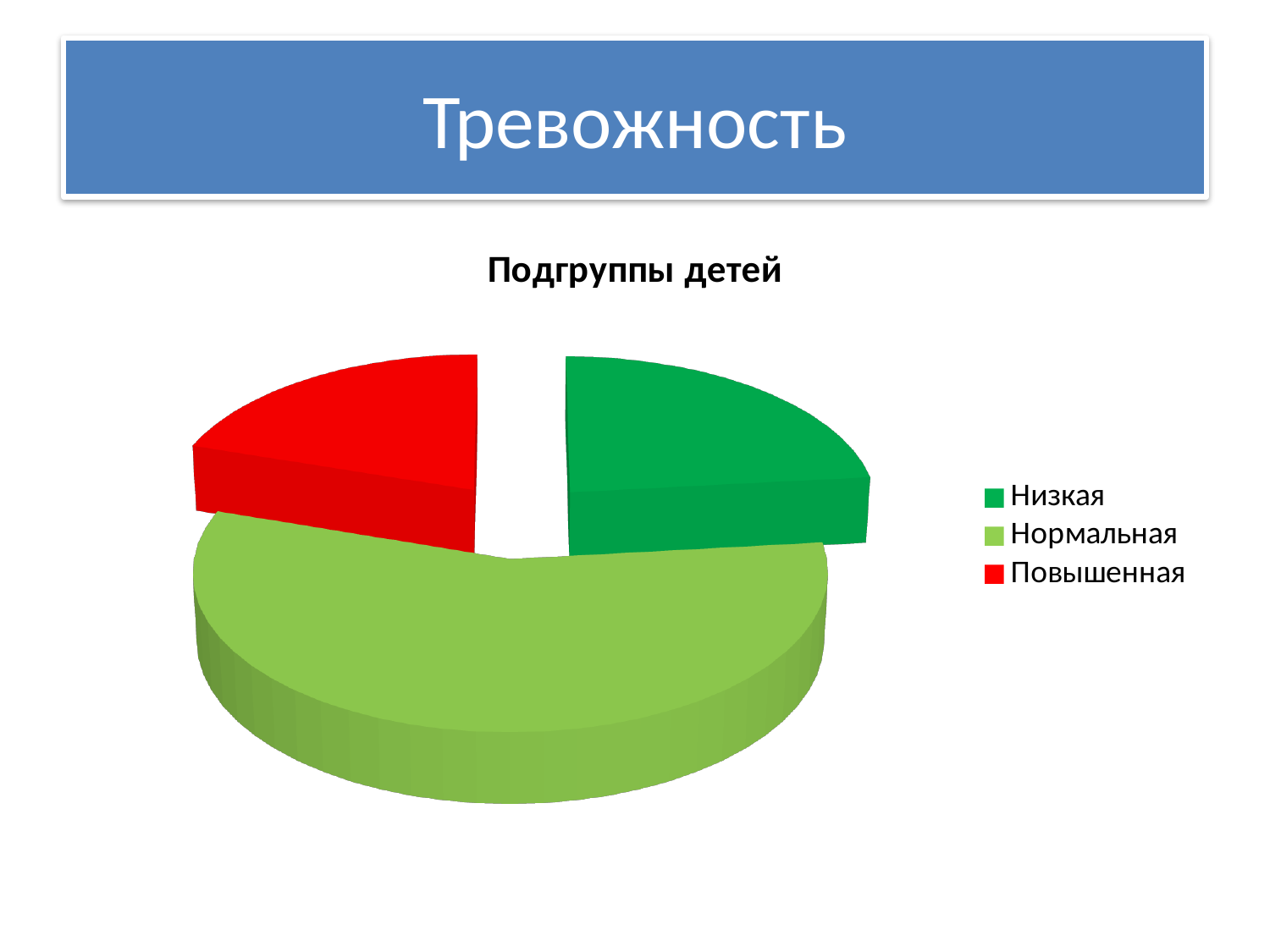
What kind of chart is shown on the slide? pie chart Which is larger, the slice for Нормальная or the slice for Низкая? Нормальная Does the slice for Нормальная take up more or less than half of the pie? more What colour is the slice for Повышенная? red How many slices does the pie chart have? 3 Which is larger, the slice for Нормальная or the slice for Повышенная? Нормальная How many entries does the legend list? 3 What is the title of the chart? Подгруппы детей Which category has the largest slice of the pie? Нормальная Does the slice for Низкая take up more or less than half of the pie? less